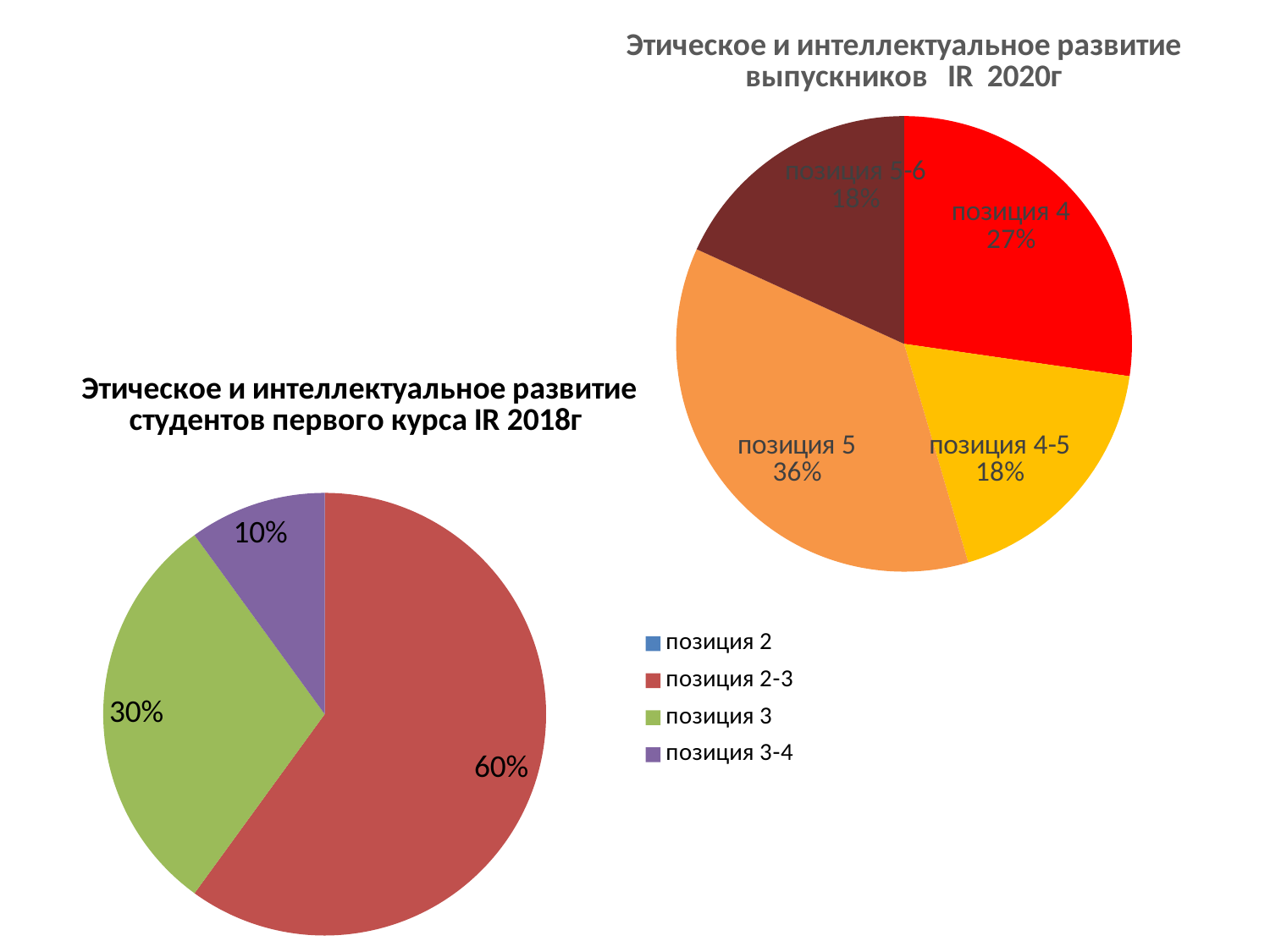
In the chart titled "Этическое и интеллектуальное развитие выпускников IR 2020г", which is larger, "позиция 4" or "позиция 4-5"? позиция 4 What kind of chart is the chart titled "Этическое и интеллектуальное развитие выпускников IR 2020г"? pie chart In the chart titled "Этическое и интеллектуальное развитие выпускников IR 2020г", what is the difference between the shares of "позиция 5" and "позиция 4"? 9% In the chart titled "Этическое и интеллектуальное развитие студентов первого курса IR 2018г", what share does the largest slice have? 60% In the chart titled "Этическое и интеллектуальное развитие выпускников IR 2020г", what share does "позиция 4" have? 27% In the chart titled "Этическое и интеллектуальное развитие выпускников IR 2020г", which slice is the largest? позиция 5 In the chart titled "Этическое и интеллектуальное развитие студентов первого курса IR 2018г", what share does the green slice ("позиция 3") have? 30% In the chart titled "Этическое и интеллектуальное развитие студентов первого курса IR 2018г", what is the difference between the 60% slice and the 10% slice? 50% In the chart titled "Этическое и интеллектуальное развитие выпускников IR 2020г", how many slices does the pie have? 4 How many entries does the legend of the chart titled "Этическое и интеллектуальное развитие студентов первого курса IR 2018г" list? 4 In the chart titled "Этическое и интеллектуальное развитие выпускников IR 2020г", what share does "позиция 4-5" have? 18%